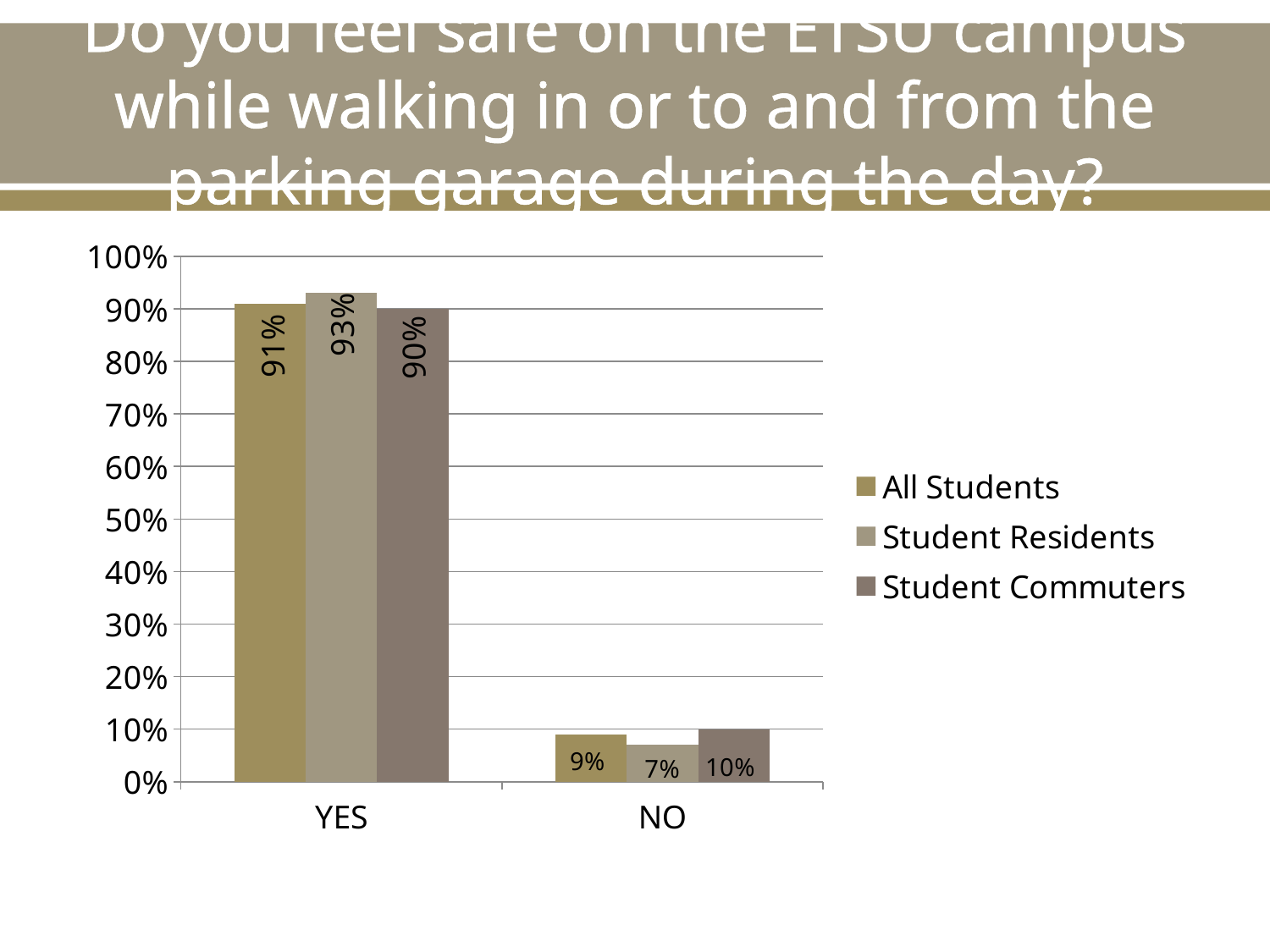
What percentage of Student Commuters answered NO? 10% Which group has the lowest percentage answering NO? Student Residents Which is larger: the NO percentage for All Students or for Student Commuters? Student Commuters What percentage of Student Residents answered NO? 7% Which group has the highest percentage answering YES? Student Residents Which legend entry is shown in the darkest colour? Student Commuters How many categories are shown on the x axis? 2 What percentage of Student Residents answered YES? 93% How many series does the legend list? 3 What is the difference between the Student Residents and Student Commuters YES percentages? 3% What kind of chart is shown on the slide? Bar chart What percentage of All Students answered YES? 91%